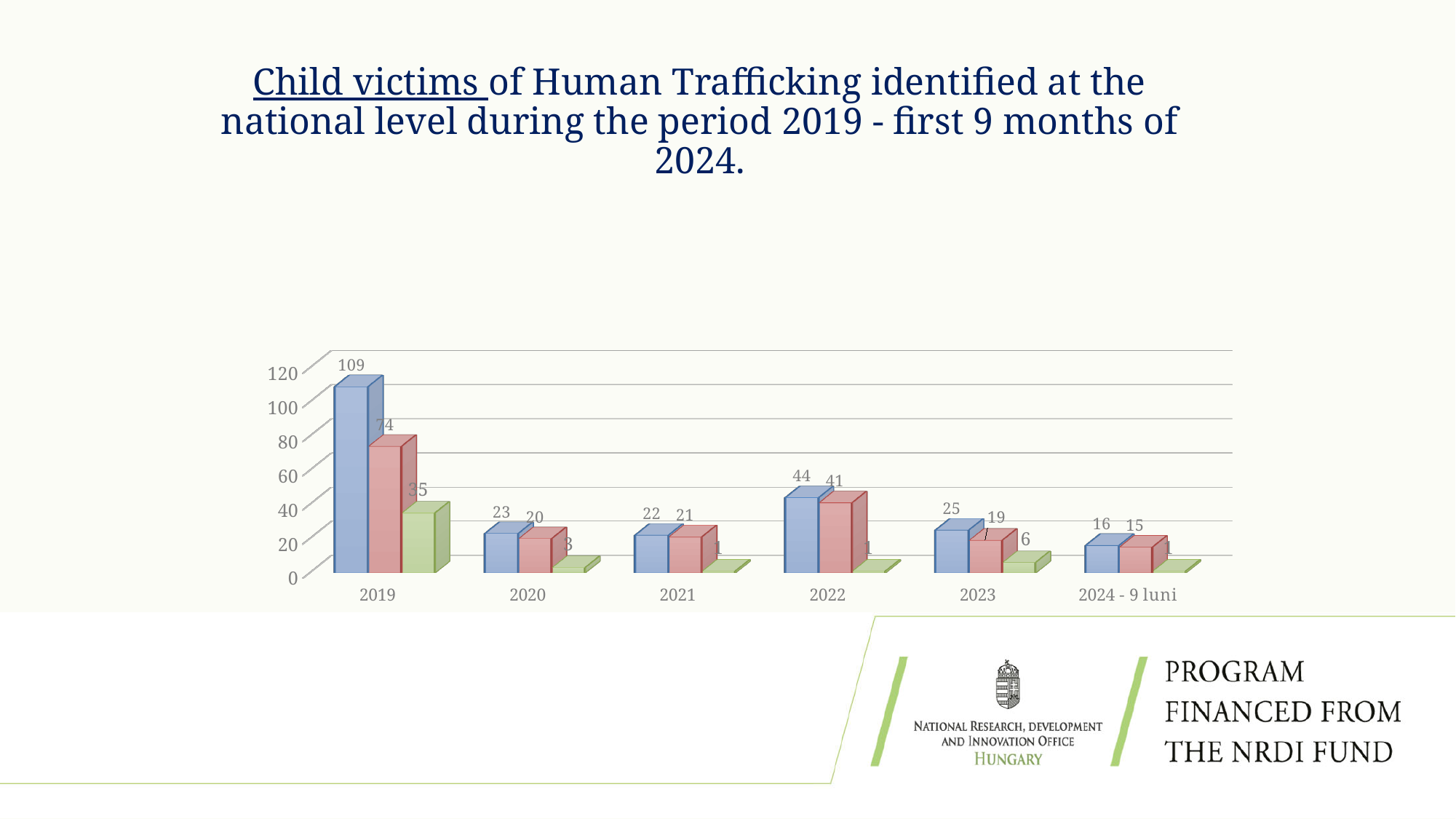
What is the difference between the blue bar for 2019 and the blue bar for 2020? 86 What is the value of the green bar for 2023? 6 What is the value of the blue bar for 2024 - 9 luni? 16 What is the difference between the blue bar and the red bar for 2019? 35 How many year categories are shown on the x axis? 6 What is the value of the blue bar for 2019? 109 What kind of chart is shown on the slide? bar chart Which is larger, the blue bar for 2022 or the blue bar for 2023? 2022 Is the value of the red bar for 2019 greater or less than 60? greater Which year has the highest blue bar? 2019 What is the value of the red bar for 2022? 41 Which year has the lowest blue bar? 2024 - 9 luni